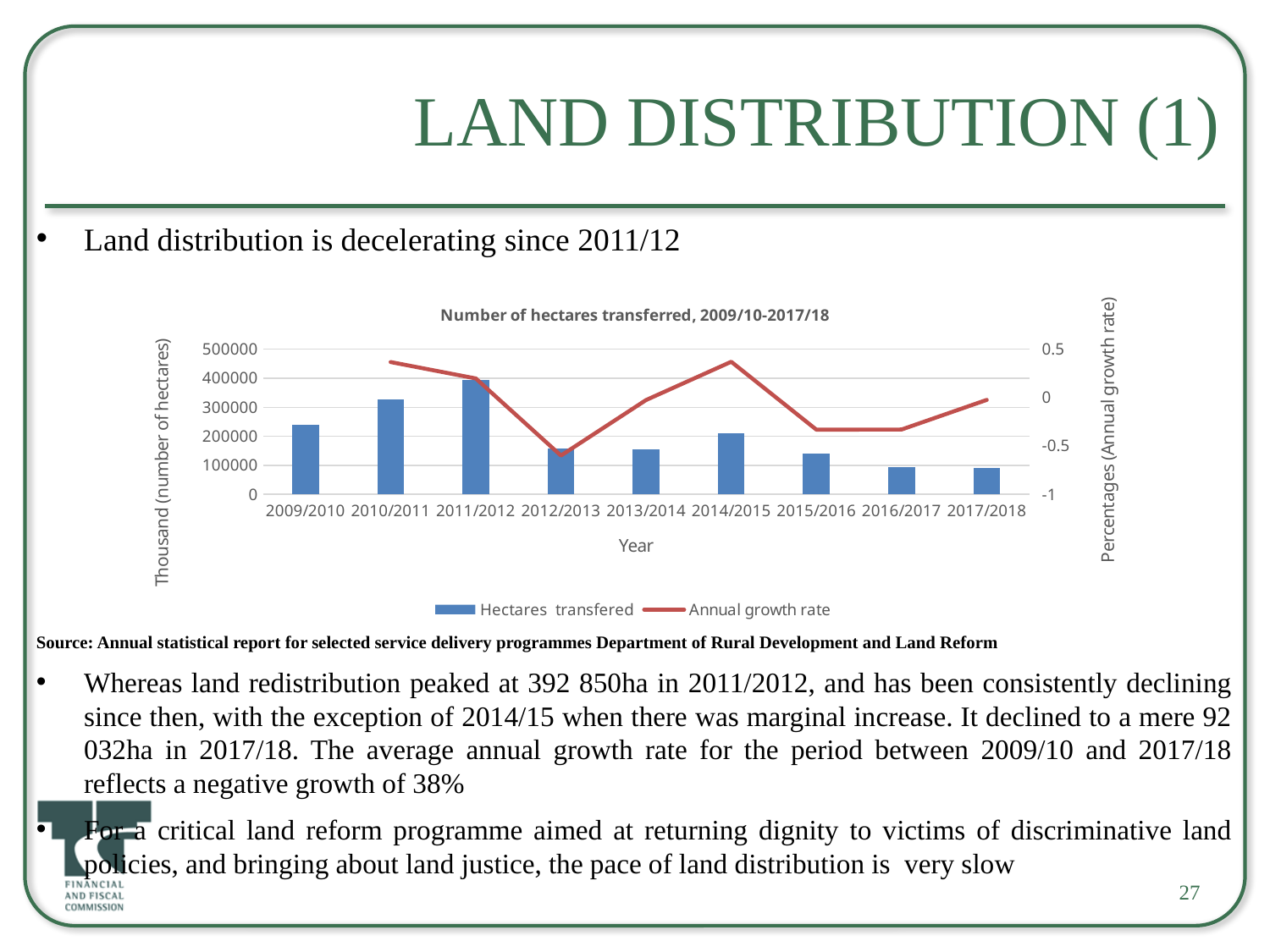
Which year has the highest bar for hectares transferred? 2011/2012 Which year has the larger bar for hectares transferred, 2010/2011 or 2013/2014? 2010/2011 How many series does the chart's legend list? 2 Which year has the lowest point on the annual growth rate line? 2012/2013 How many years are shown on the x axis of the chart? 9 Do the hectares transferred bars rise or fall from 2014/2015 to 2017/2018? fall Is the hectares transferred value for 2010/2011 greater or less than 300000? greater Is the hectares transferred value for 2009/2010 greater or less than 200000? greater Is the annual growth rate for 2015/2016 greater or less than 0? less What is the title of the chart? Number of hectares transferred, 2009/10-2017/18 What kind of chart is shown on the slide? A bar chart combined with a line